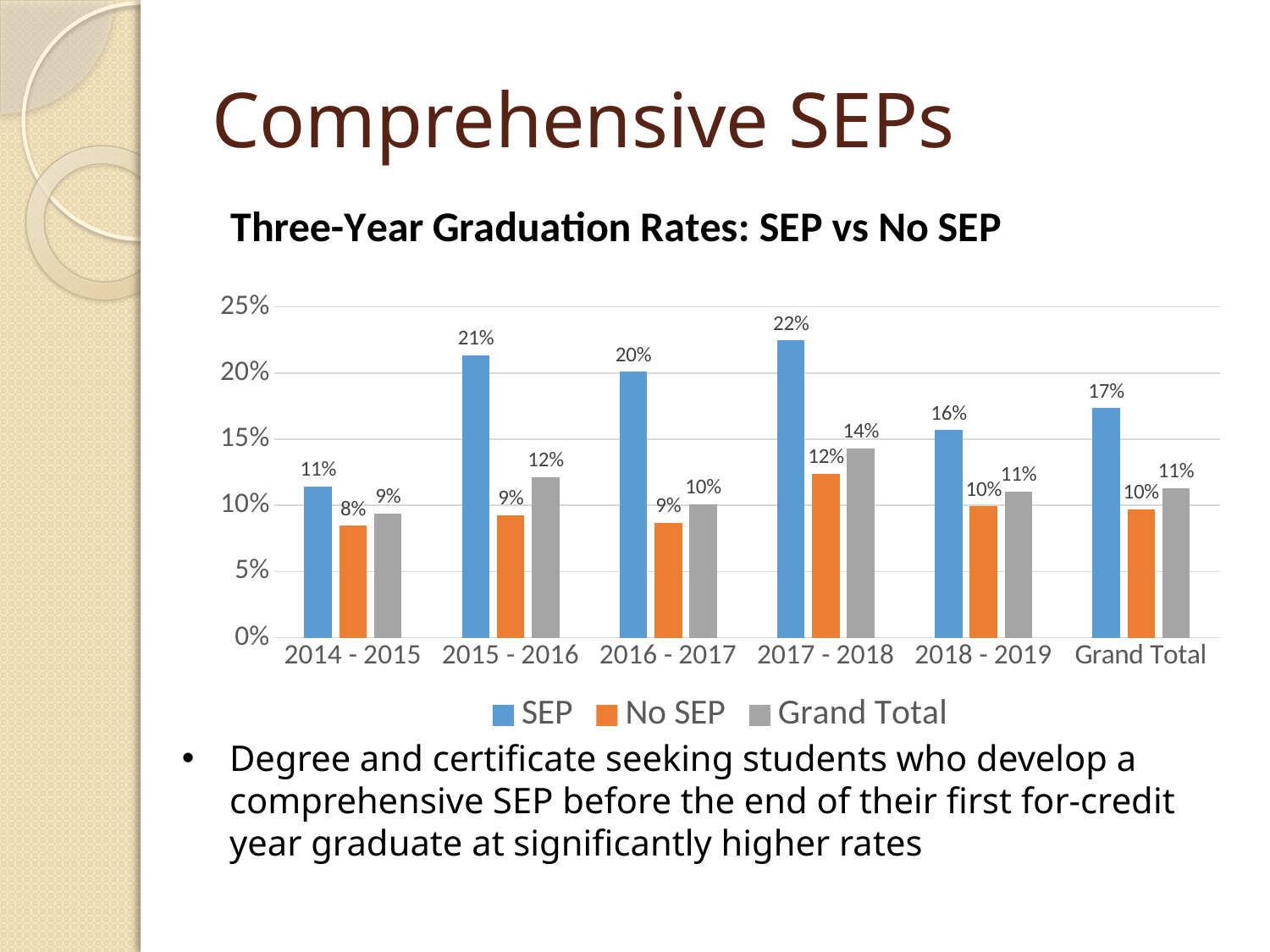
What is the SEP graduation rate in the Grand Total category? 17% In which year is the SEP graduation rate highest? 2017 - 2018 Is the SEP value for 2015 - 2016 greater or less than 20%? greater Which is larger for 2018 - 2019, the SEP rate or the No SEP rate? SEP What is the SEP three-year graduation rate for 2017 - 2018? 22% In which year is the No SEP graduation rate lowest? 2014 - 2015 How many series does the legend list? 3 What is the Grand Total graduation rate for 2015 - 2016? 12% What is the difference between the SEP and No SEP graduation rates for 2016 - 2017? 11% What is the No SEP graduation rate for 2014 - 2015? 8% What kind of chart is shown on the slide? Bar chart How many categories are shown on the x axis? 6